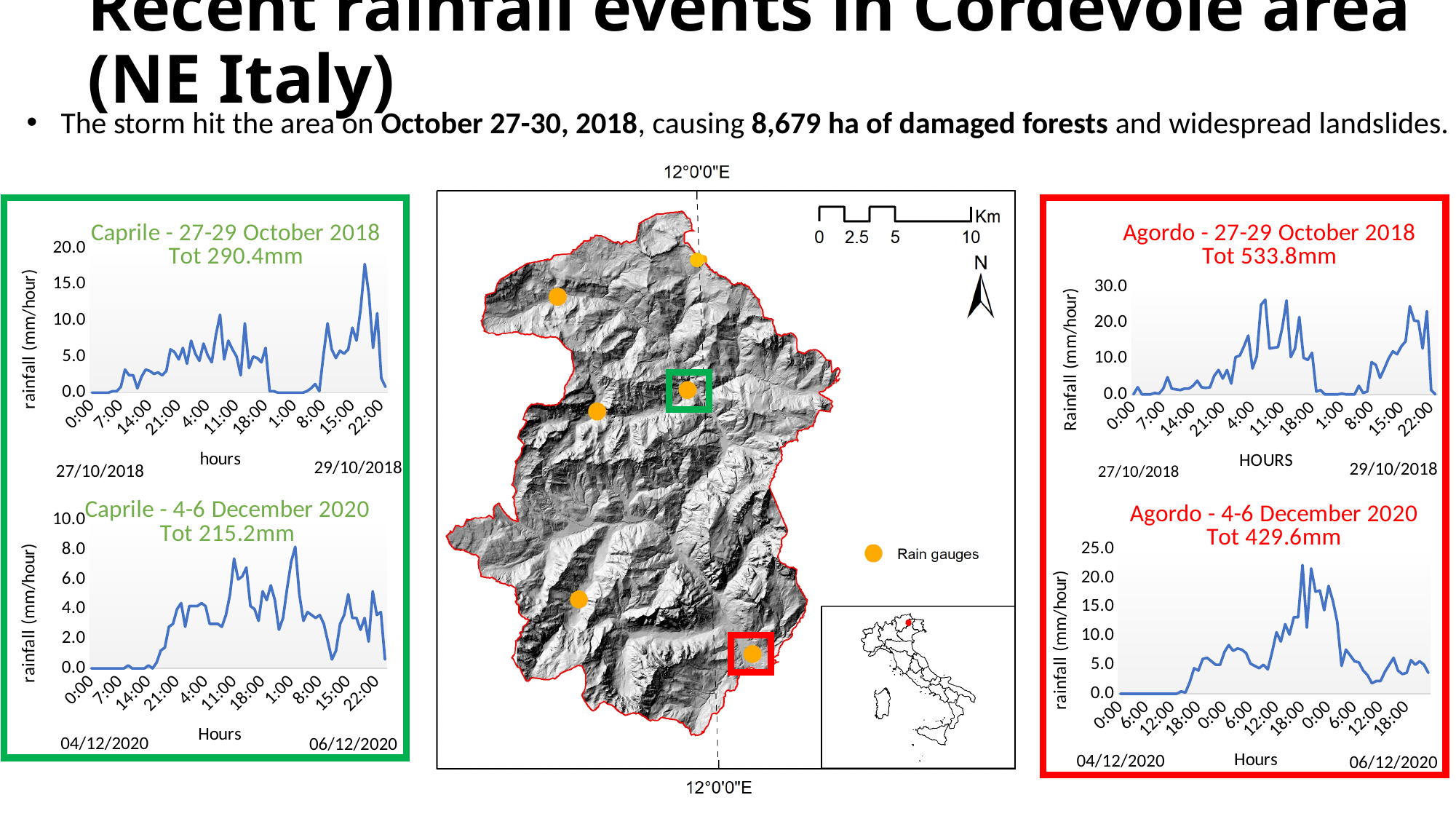
What is the difference between the total rainfall at Agordo and at Caprile for 4-6 December 2020? 214.4mm What kind of chart is the 'Caprile - 27-29 October 2018' chart? line chart In the 'Agordo - 27-29 October 2018' chart, is the highest peak greater or less than 20.0 mm/hour? greater How many rainfall charts are shown on the slide? 4 Which station recorded the larger total rainfall for 27-29 October 2018, Caprile or Agordo? Agordo What total rainfall is stated in the title of the 'Agordo - 27-29 October 2018' chart? 533.8mm What total rainfall is stated in the title of the 'Agordo - 4-6 December 2020' chart? 429.6mm What is the difference between the total rainfall at Agordo and at Caprile for 27-29 October 2018? 243.4mm What is the y-axis label on the 'Caprile - 4-6 December 2020' chart? rainfall (mm/hour) In the 'Caprile - 27-29 October 2018' chart, is the highest peak greater or less than 15.0 mm/hour? greater What total rainfall is stated in the title of the 'Caprile - 4-6 December 2020' chart? 215.2mm In the 'Agordo - 4-6 December 2020' chart, is the highest peak greater or less than 15.0 mm/hour? greater